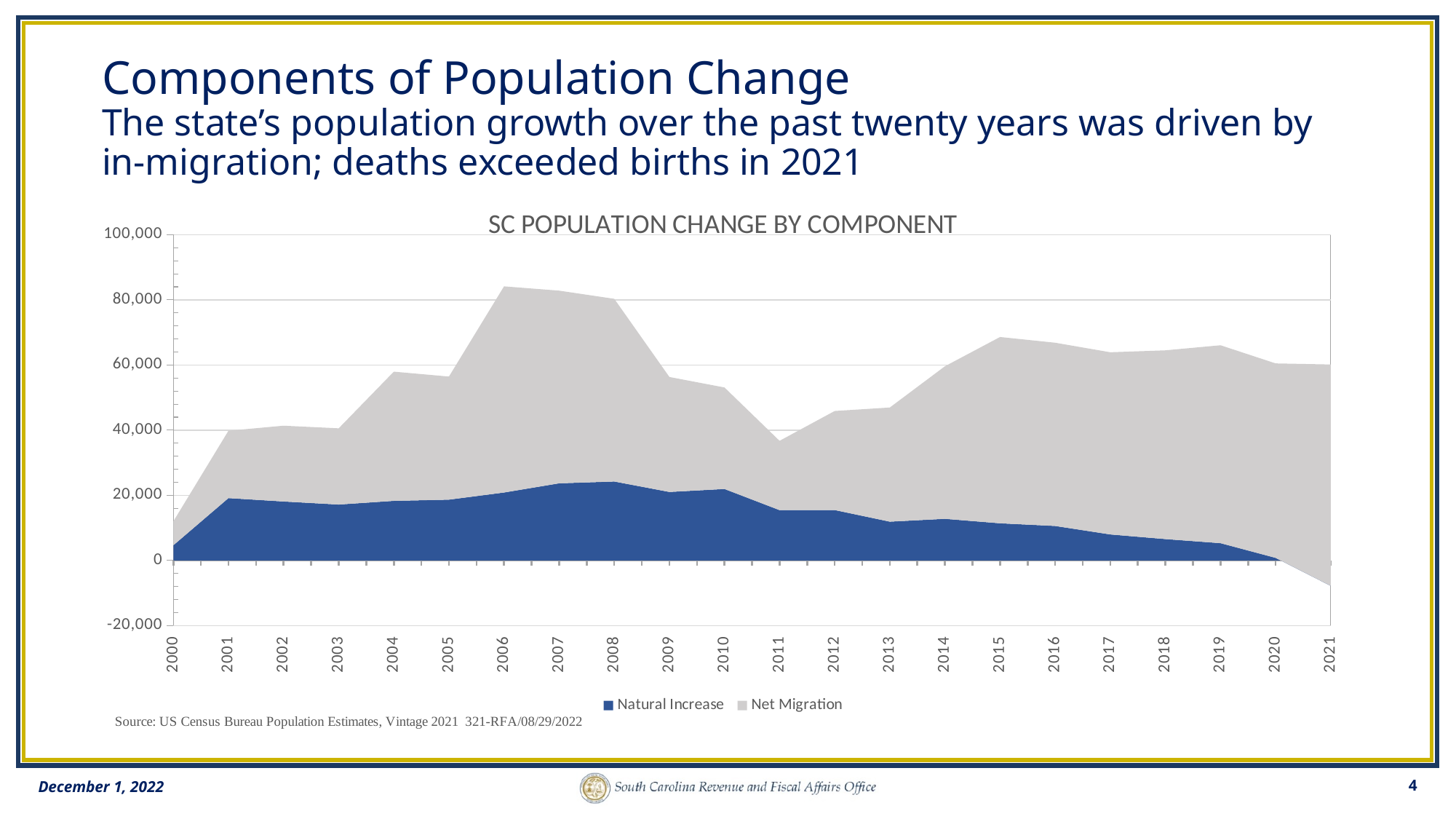
Is the value for Natural Increase in 2021 greater or less than 0? less How many series does the legend list? 2 Does Natural Increase rise or fall from 2008 to 2021? fall Which series is shown in dark blue? Natural Increase Is the value for Natural Increase in 2008 greater or less than 20,000? greater Is the total population change in 2006 greater or less than 80,000? greater How many years are plotted along the x axis? 22 What is the title of the chart? SC POPULATION CHANGE BY COMPONENT In which year is the total population change (top of the stacked area) highest? 2006 What kind of chart is shown on the slide? Stacked area chart In which year is the total population change (top of the stacked area) lowest? 2000 Which is larger, Natural Increase in 2001 or Natural Increase in 2019? 2001